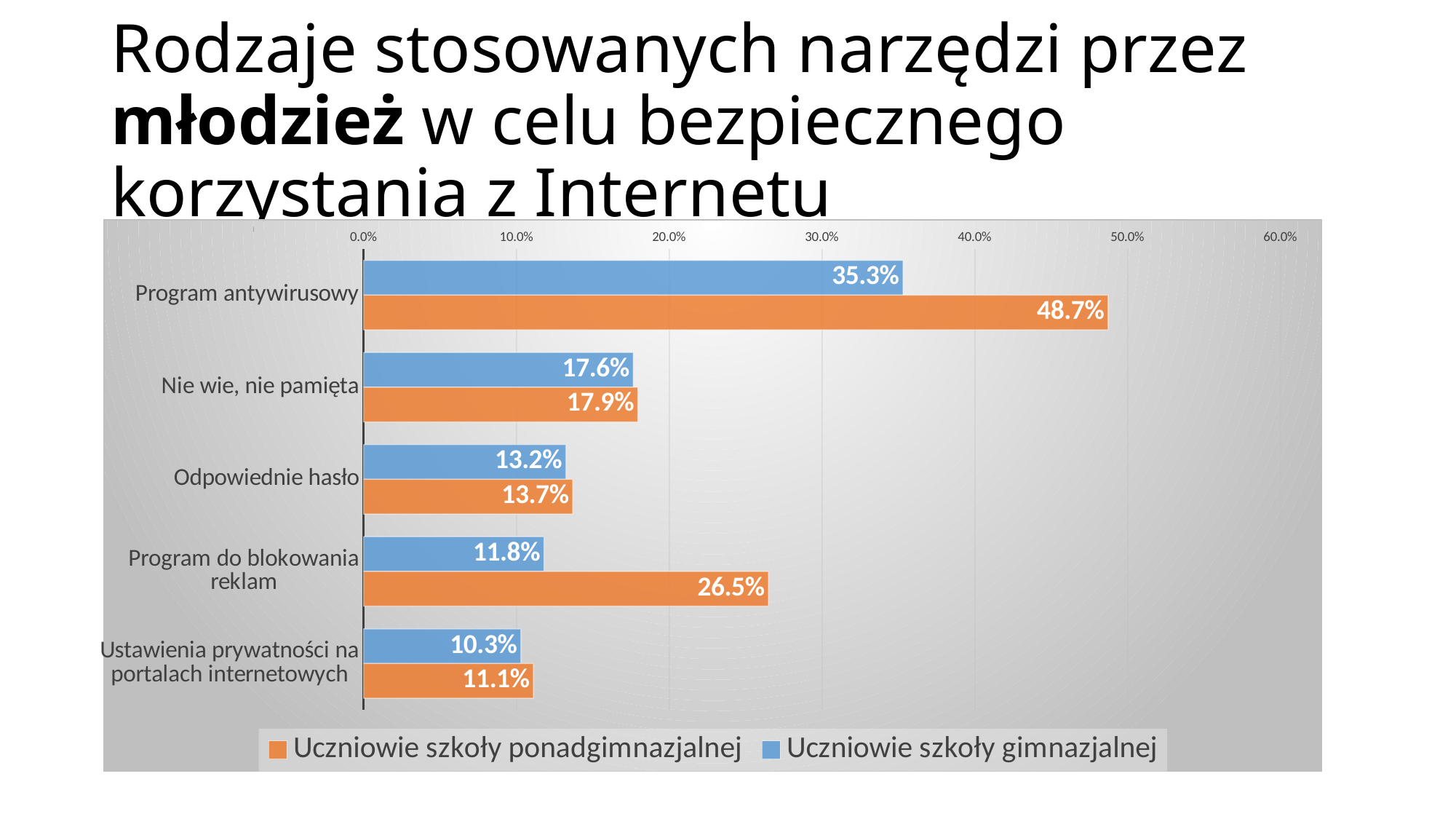
What is the value for Program do blokowania reklam for Uczniowie szkoły gimnazjalnej? 11.8% Which is larger for Program do blokowania reklam: Uczniowie szkoły ponadgimnazjalnej or Uczniowie szkoły gimnazjalnej? Uczniowie szkoły ponadgimnazjalnej What kind of chart is shown on the slide? bar chart Which category has the highest value for Uczniowie szkoły gimnazjalnej? Program antywirusowy How many series does the legend list? 2 What is the difference between the Uczniowie szkoły ponadgimnazjalnej and Uczniowie szkoły gimnazjalnej values for Program do blokowania reklam? 14.7% How many categories are shown on the chart? 5 What is the difference between the Uczniowie szkoły ponadgimnazjalnej and Uczniowie szkoły gimnazjalnej values for Program antywirusowy? 13.4% What is the value for Program antywirusowy for Uczniowie szkoły ponadgimnazjalnej? 48.7% Which category has the lowest value for Uczniowie szkoły ponadgimnazjalnej? Ustawienia prywatności na portalach internetowych Is the value for Program antywirusowy for Uczniowie szkoły gimnazjalnej greater or less than 30.0%? greater What is the value for Nie wie, nie pamięta for Uczniowie szkoły gimnazjalnej? 17.6%